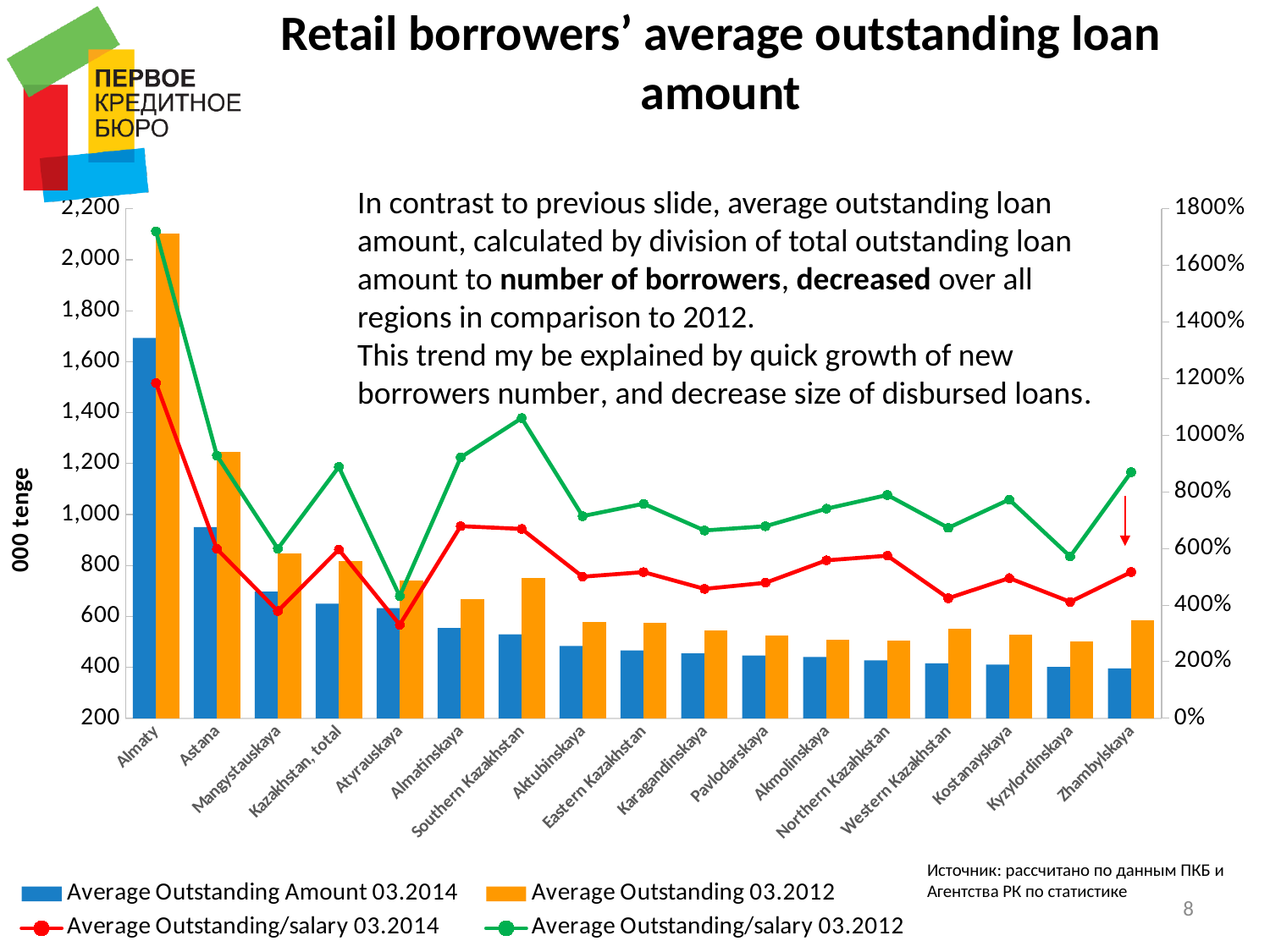
How many series does the legend list? 4 What is the label of the left vertical axis? 000 tenge Which is larger, the Average Outstanding 03.2012 for Southern Kazakhstan or for Almatinskaya? Southern Kazakhstan Is the Average Outstanding 03.2012 for Astana greater or less than 1,000? greater Which region has the lowest Average Outstanding/salary 03.2012 (green line)? Atyrauskaya Which region has the highest Average Outstanding Amount 03.2014 (blue bar)? Almaty Is the Average Outstanding/salary 03.2012 for Southern Kazakhstan greater or less than 800%? greater Is the Average Outstanding Amount 03.2014 for Almaty greater or less than 1,600? greater What kind of chart is shown on the slide? A combined bar and line chart How many regions (categories) are shown on the x axis? 17 Which region has the highest Average Outstanding 03.2012 (orange bar)? Almaty Do the Average Outstanding Amount 03.2014 bars generally rise or fall from left to right across the regions? fall